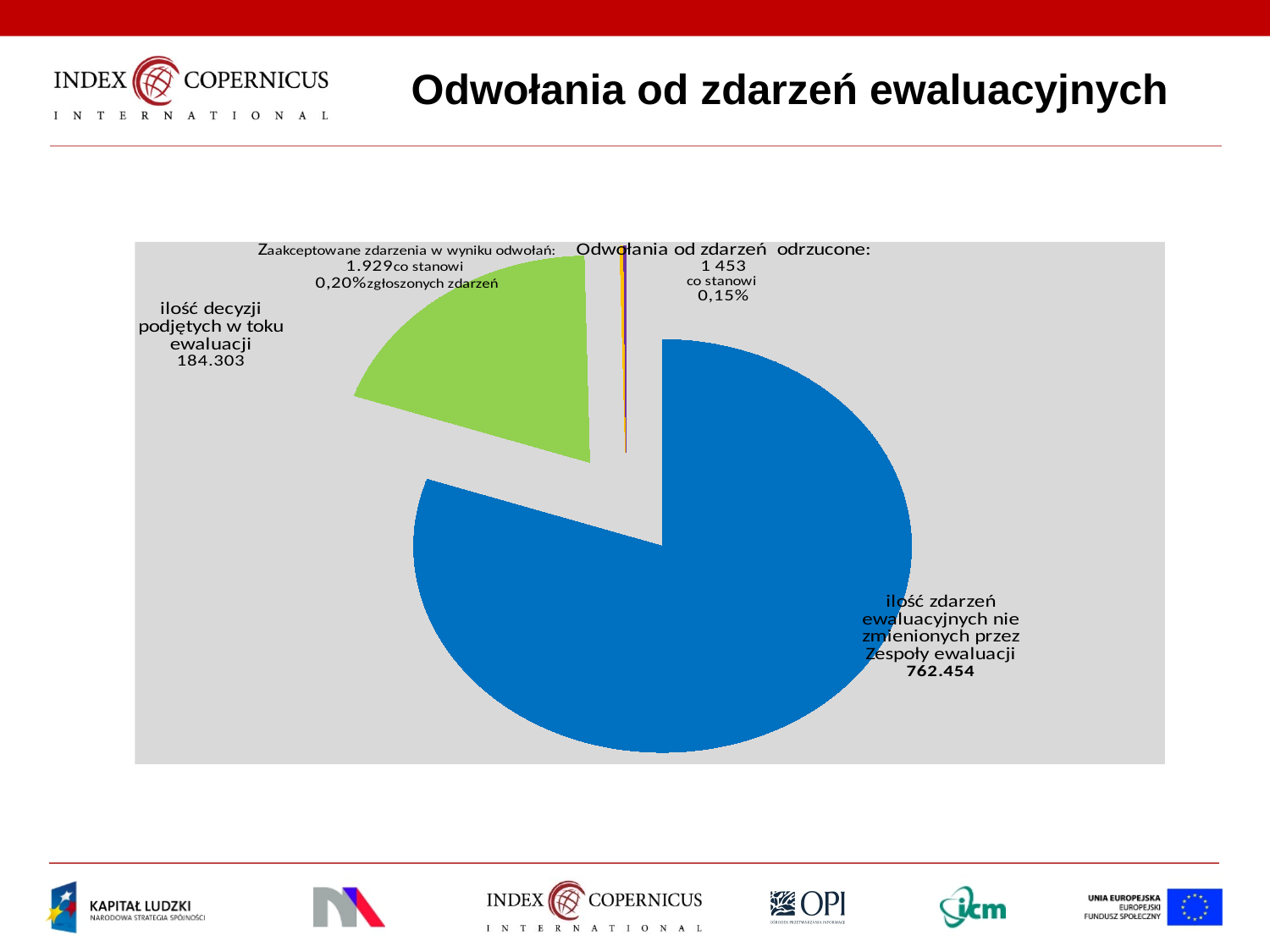
Which is larger: 'ilość decyzji podjętych w toku ewaluacji' or 'Zaakceptowane zdarzenia w wyniku odwołań'? ilość decyzji podjętych w toku ewaluacji How many slices does the pie chart have? 4 What kind of chart is shown on the slide? pie chart What is the value for 'ilość decyzji podjętych w toku ewaluacji'? 184.303 What share of reported events do the 'Zaakceptowane zdarzenia w wyniku odwołań' represent? 0,20% What is the difference between 'ilość zdarzeń ewaluacyjnych nie zmienionych przez Zespoły ewaluacji' and 'ilość decyzji podjętych w toku ewaluacji'? 578.151 What share do the 'Odwołania od zdarzeń odrzucone' represent? 0,15% What is the value for 'Odwołania od zdarzeń odrzucone'? 1 453 What is the value for 'ilość zdarzeń ewaluacyjnych nie zmienionych przez Zespoły ewaluacji'? 762.454 Which slice of the pie is the largest? ilość zdarzeń ewaluacyjnych nie zmienionych przez Zespoły ewaluacji Which slice of the pie is the smallest? Odwołania od zdarzeń odrzucone What is the value for 'Zaakceptowane zdarzenia w wyniku odwołań'? 1.929